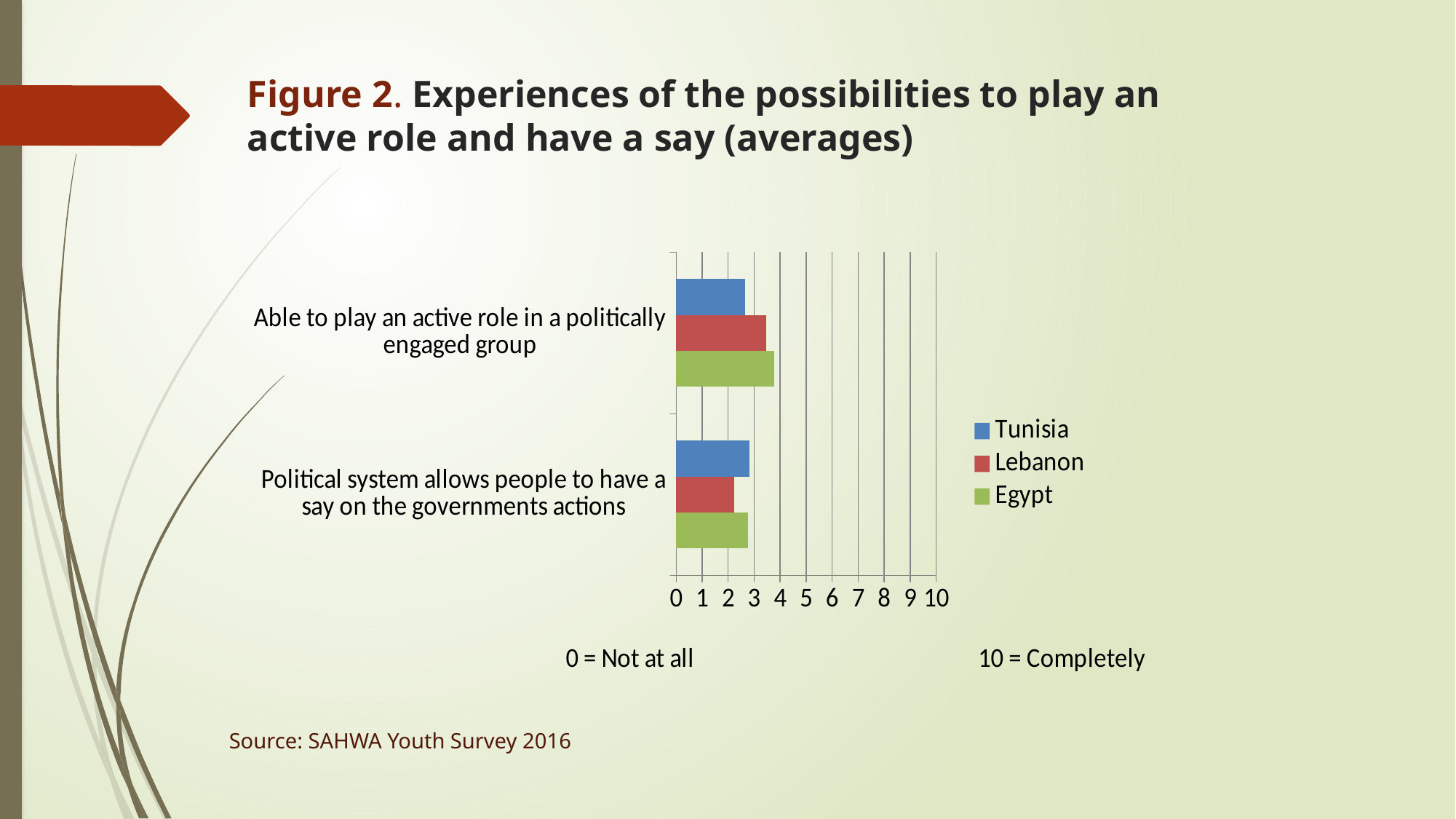
For 'Able to play an active role in a politically engaged group', which is larger: the value for Lebanon or the value for Tunisia? Lebanon What does a value of 0 on the axis mean according to the slide? Not at all Which country has the lowest value for 'Able to play an active role in a politically engaged group'? Tunisia How many series does the legend list? 3 What kind of chart is shown on the slide? bar chart Is the value for Egypt on 'Able to play an active role in a politically engaged group' greater or less than 3? greater How many categories are plotted on the chart? 2 Is the value for Tunisia on 'Political system allows people to have a say on the governments actions' greater or less than 2? greater Which countries are listed in the legend? Tunisia, Lebanon, Egypt Is the value for Lebanon on 'Political system allows people to have a say on the governments actions' greater or less than 3? less Which country has the highest value for 'Able to play an active role in a politically engaged group'? Egypt Which country has the lowest value for 'Political system allows people to have a say on the governments actions'? Lebanon